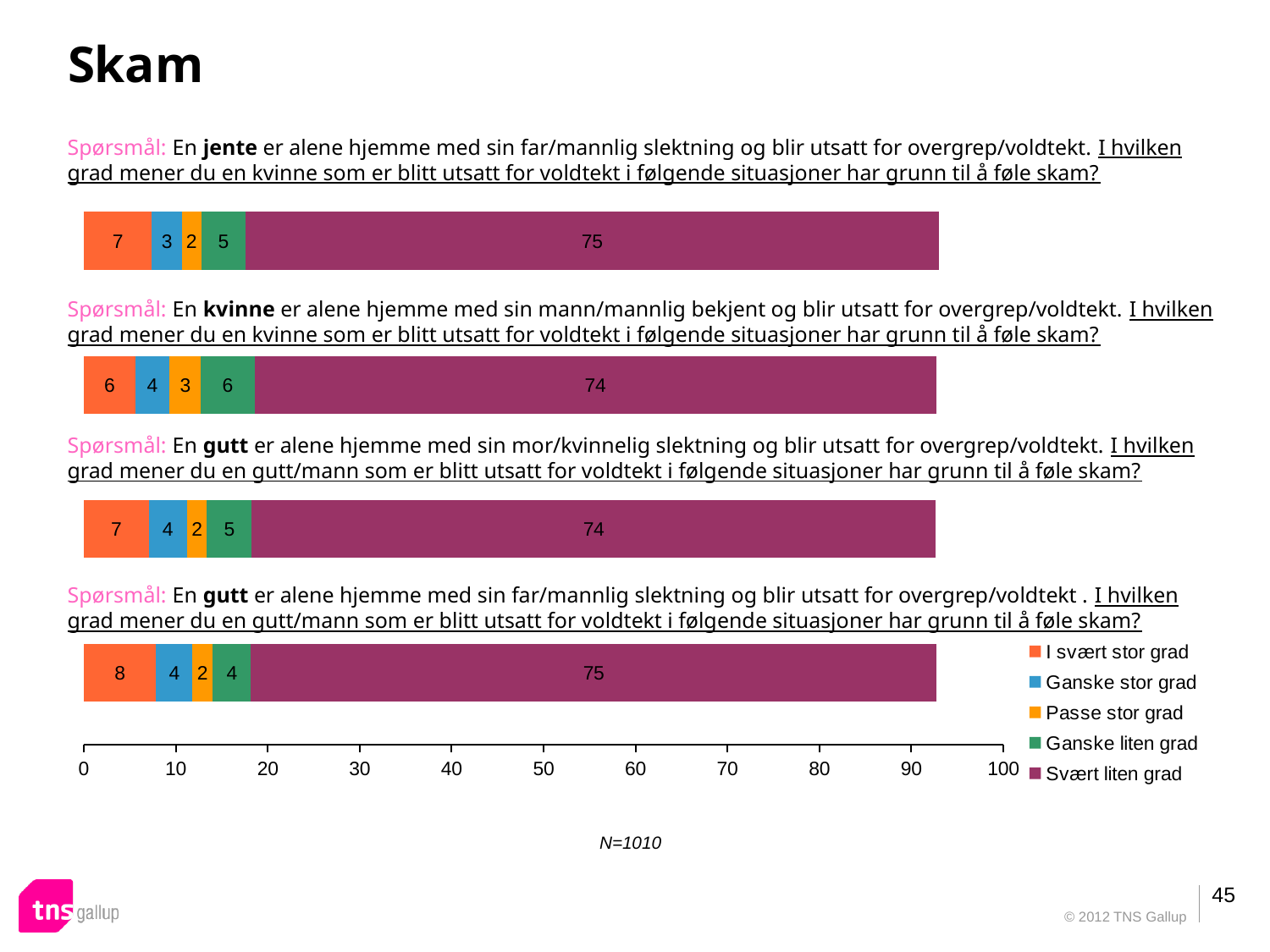
In the fourth bar (gutt alone with far/mannlig slektning), what is the value for 'Ganske liten grad'? 4 In the first bar (jente alone with far/mannlig slektning), what is the value for 'Svært liten grad'? 75 How many series does the legend list? 5 What kind of chart is shown on the slide? stacked bar chart How many bars are plotted on the slide? 4 What is the difference between 'Svært liten grad' and 'I svært stor grad' in the first bar (jente alone with far/mannlig slektning)? 68 What is the total of all segments in the fourth bar (gutt alone with far/mannlig slektning)? 93 Which segment is the largest in the first bar (jente alone with far/mannlig slektning)? Svært liten grad In the second bar (kvinne alone with mann/mannlig bekjent), what is the value for 'I svært stor grad'? 6 Which is larger: 'I svært stor grad' in the fourth bar (gutt with far) or 'I svært stor grad' in the second bar (kvinne with mann)? fourth bar (gutt with far) In the third bar (gutt alone with mor/kvinnelig slektning), what is the value for 'Ganske stor grad'? 4 Which segment is the smallest in the second bar (kvinne alone with mann/mannlig bekjent)? Passe stor grad